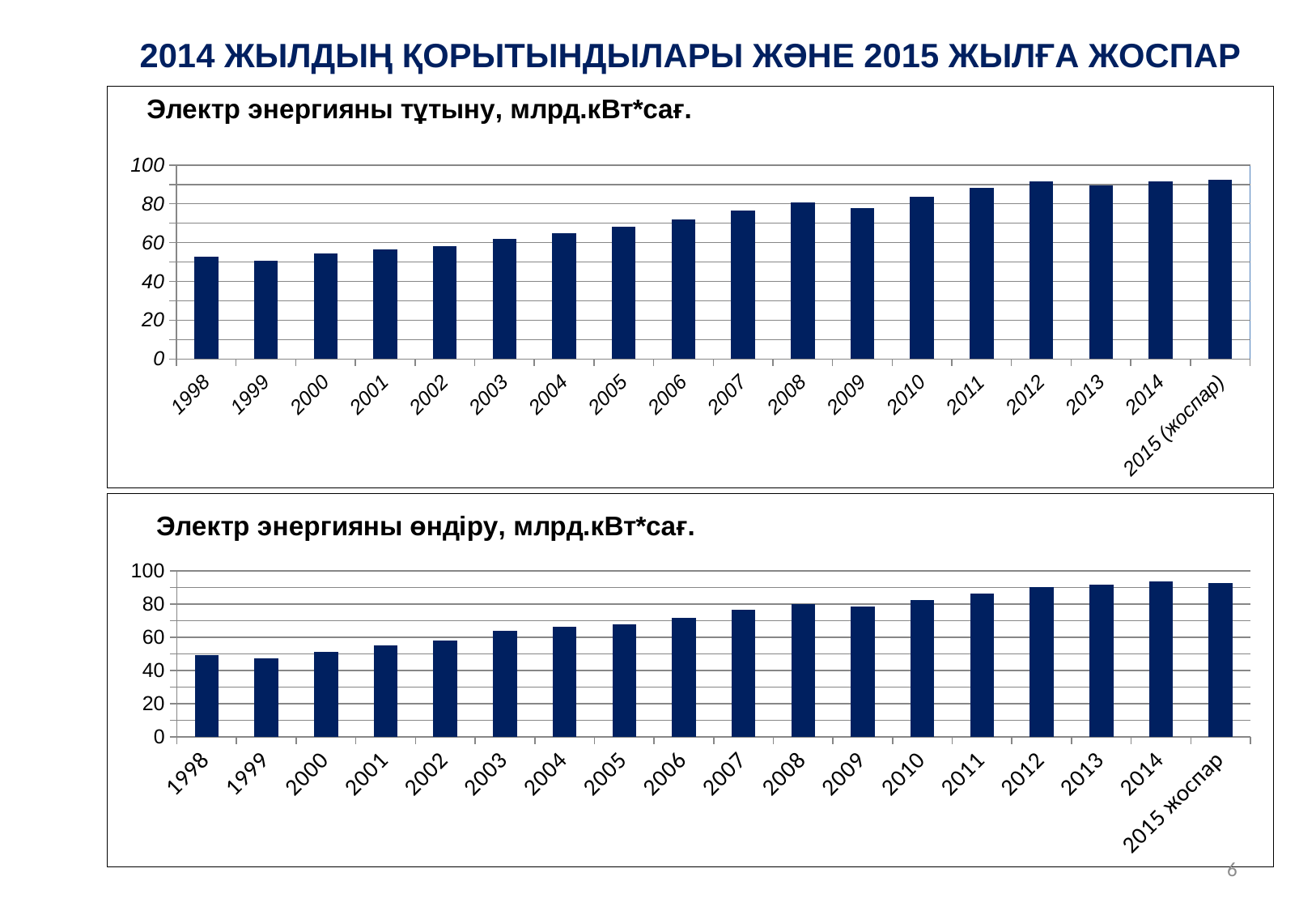
In the top chart (Электр энергияны тұтыну), is the value for 2006 greater or less than 60? greater In the bottom chart (Электр энергияны өндіру), is the value for 2013 greater or less than 80? greater In the top chart (Электр энергияны тұтыну), which is larger, the value for 2008 or the value for 2002? 2008 In the top chart (Электр энергияны тұтыну), do the values generally rise or fall from 1999 to 2012? rise What kind of chart is the top chart, "Электр энергияны тұтыну, млрд.кВт*сағ."? bar chart In the top chart (Электр энергияны тұтыну), is the value for 1998 greater or less than 60? less What is the title of the bottom chart? Электр энергияны өндіру, млрд.кВт*сағ. In the bottom chart (Электр энергияны өндіру), which year has the lowest value? 1999 In the top chart (Электр энергияны тұтыну), how many years/categories are shown on the x axis? 18 In the top chart (Электр энергияны тұтыну), which year has the lowest value? 1999